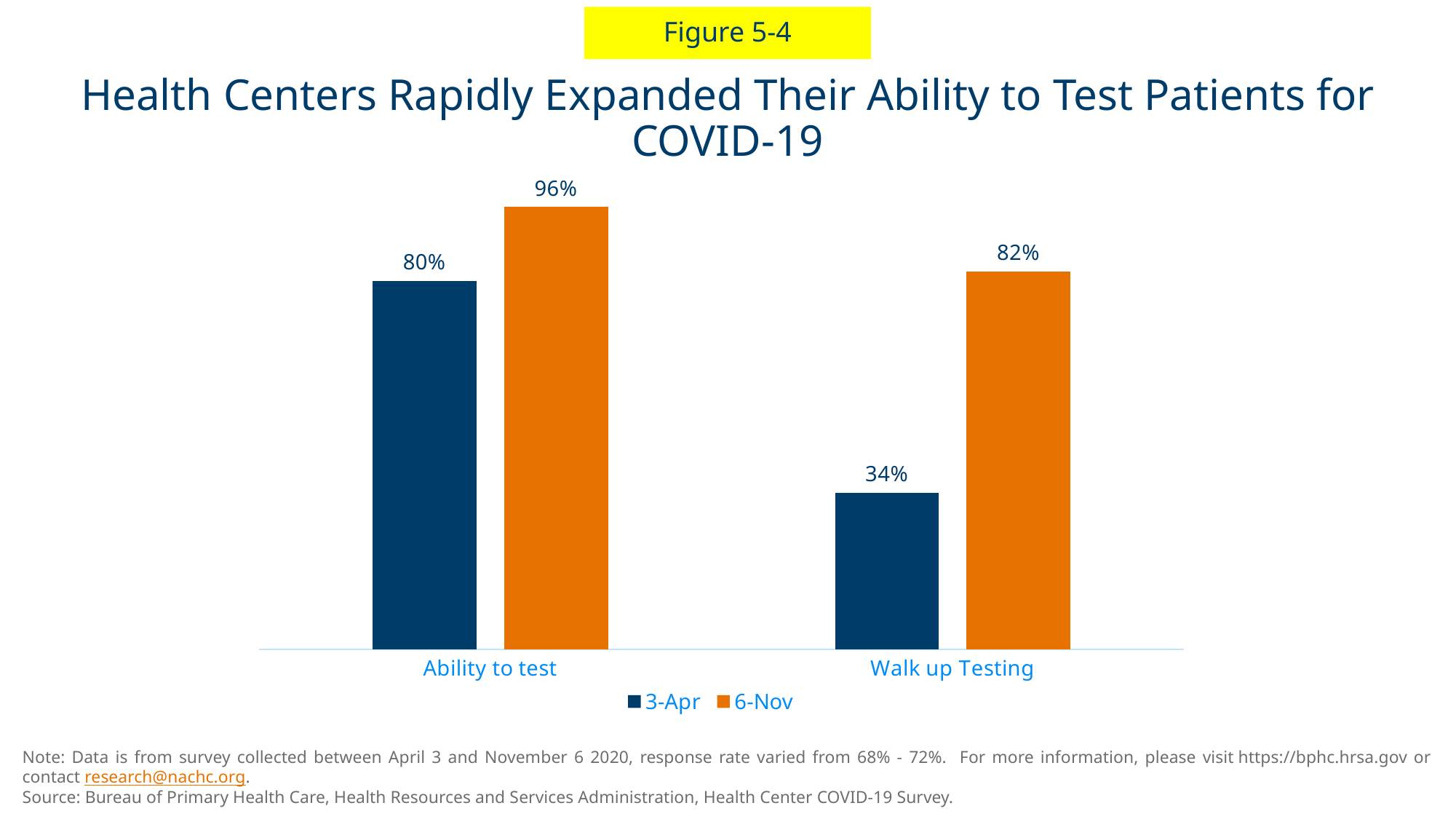
What is the value for 6-Nov in the Ability to test category? 96% How many series does the legend list? 2 What is the difference between the 6-Nov and 3-Apr values for Walk up Testing? 48% What kind of chart is shown on the slide? Bar chart Which bar has the lowest value on the chart? 3-Apr, Walk up Testing Which is larger: the 3-Apr value for Ability to test or the 6-Nov value for Walk up Testing? 6-Nov value for Walk up Testing What is the difference between the 6-Nov and 3-Apr values for Ability to test? 16% How many categories are shown on the x axis? 2 Which bar has the highest value on the chart? 6-Nov, Ability to test What is the value for 3-Apr in the Ability to test category? 80% What is the value for 6-Nov in the Walk up Testing category? 82% What is the value for 3-Apr in the Walk up Testing category? 34%